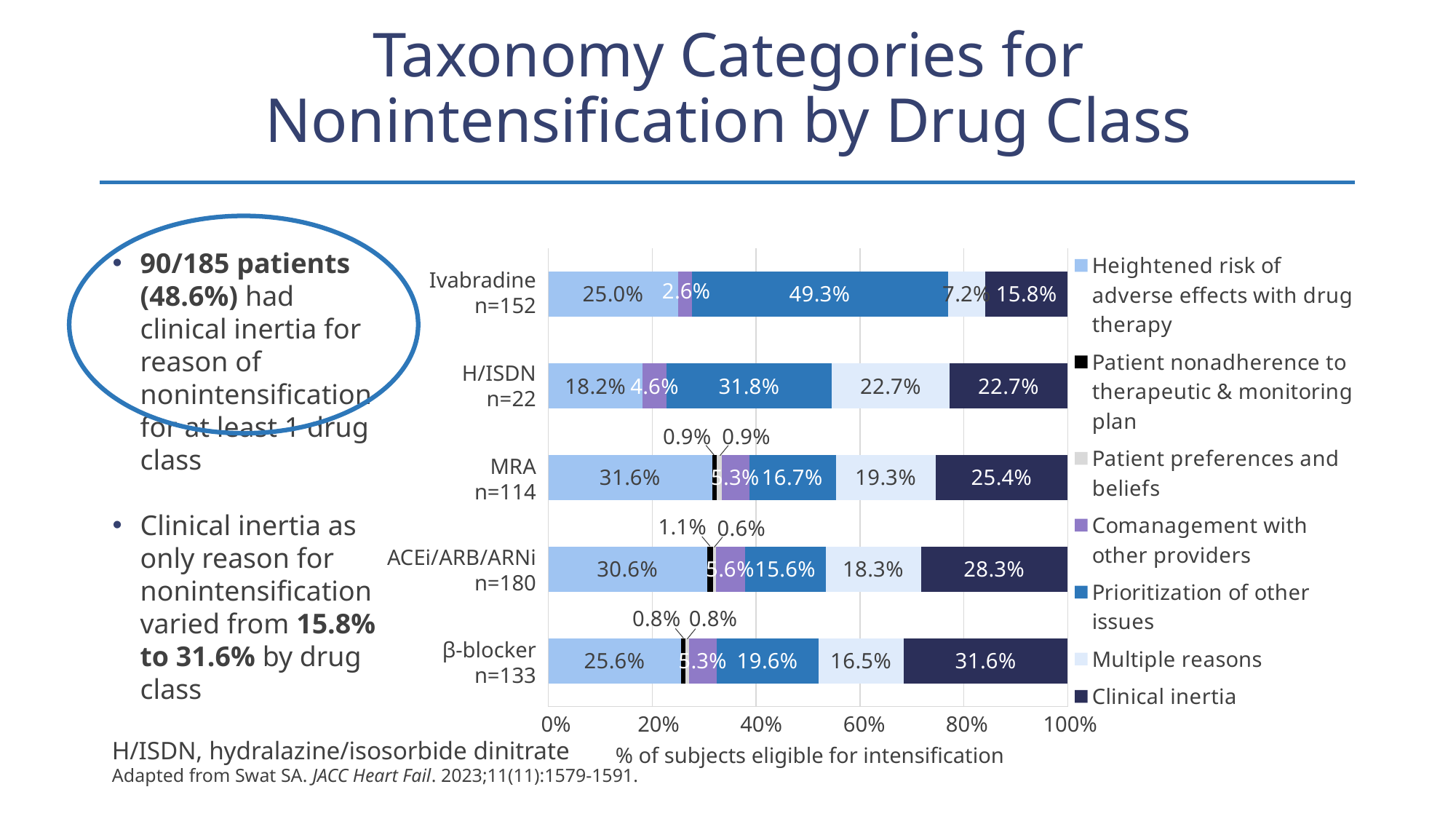
Which drug class has the lowest percentage for clinical inertia? Ivabradine What percentage of Ivabradine subjects had clinical inertia as the reason for nonintensification? 15.8% Which drug class has the highest percentage for clinical inertia? β-blocker What is the value for 'Prioritization of other issues' in the Ivabradine bar? 49.3% How many drug classes are shown on the chart? 5 What is the 'Multiple reasons' value for H/ISDN? 22.7% What is the sample size (n) shown for ACEi/ARB/ARNi? n=180 What is the label of the horizontal axis of the chart? % of subjects eligible for intensification What is the difference in the clinical inertia percentage between β-blocker and Ivabradine? 15.8 percentage points What type of chart is shown on the slide? Stacked bar chart Which has a larger 'Heightened risk of adverse effects with drug therapy' value, MRA or H/ISDN? MRA How many categories does the legend list? 7